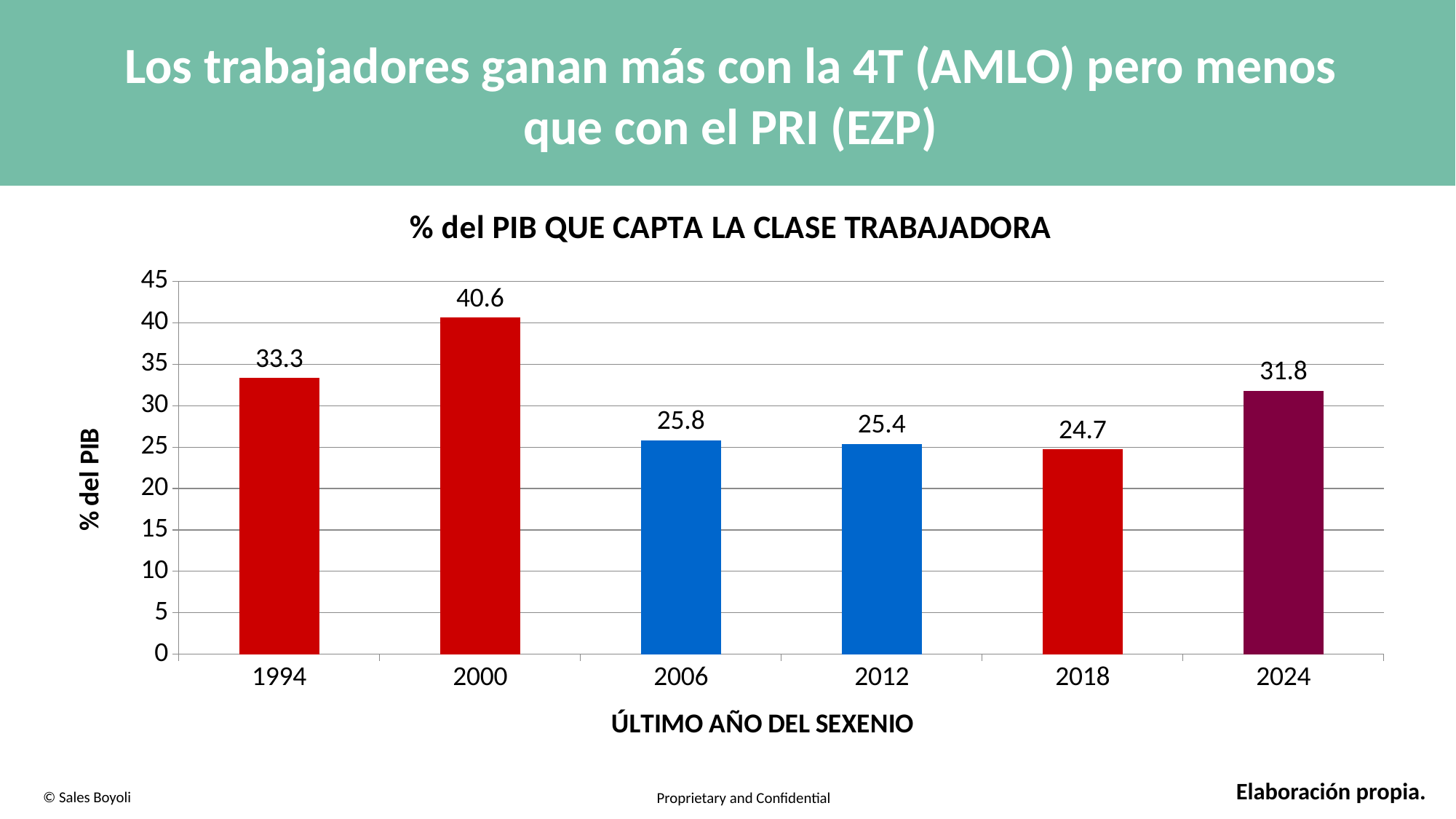
Which year has the highest value? 2000 Which year has the lowest value? 2018 What is the title of the chart? % del PIB QUE CAPTA LA CLASE TRABAJADORA What is the value for 2024? 31.8 What kind of chart is shown? bar chart Is the value for 2006 greater or less than 30? less What is the value for 2000? 40.6 How many years are shown on the x axis? 6 Which is larger, the value for 1994 or the value for 2024? 1994 What is the value for 2018? 24.7 What is the difference between the values for 2000 and 2024? 8.8 What is the difference between the values for 1994 and 2018? 8.6